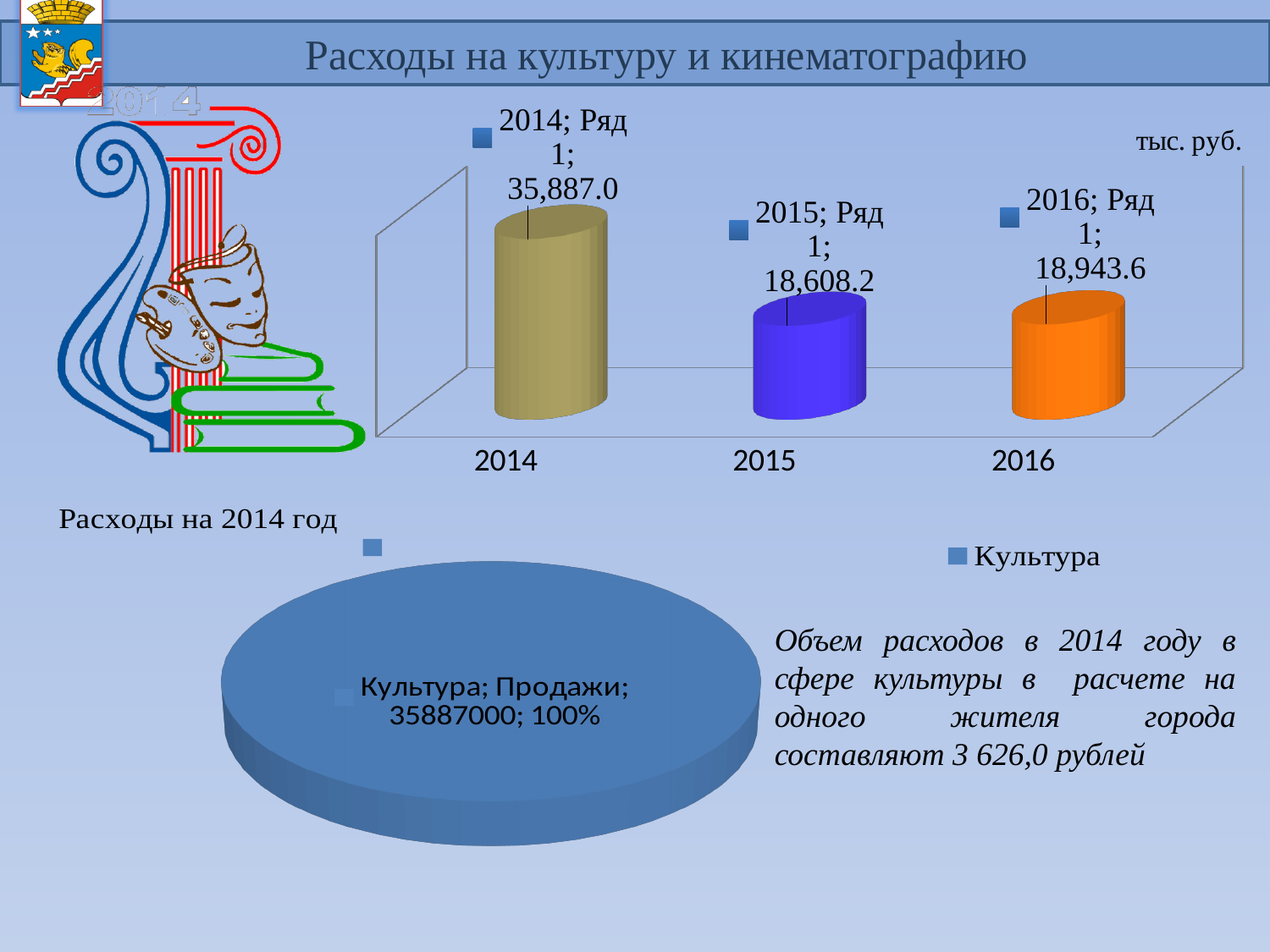
In the pie chart 'Расходы на 2014 год', what value is shown for Культура? 35887000 How many years are shown in the top bar chart? 3 What kind of chart is the top chart on the slide? bar chart In the top bar chart, what is the value for 2015? 18,608.2 In the top bar chart, which year has the highest value? 2014 In the top bar chart, what is the value for 2014? 35,887.0 In the top bar chart, what is the difference between the values for 2014 and 2015? 17,278.8 In the top bar chart, what is the difference between the values for 2016 and 2015? 335.4 In the pie chart 'Расходы на 2014 год', what share does the Культура slice have? 100% In the top bar chart, which year has the lowest value? 2015 In the top bar chart, what is the value for 2016? 18,943.6 In the top bar chart, which is larger, the value for 2015 or the value for 2016? 2016